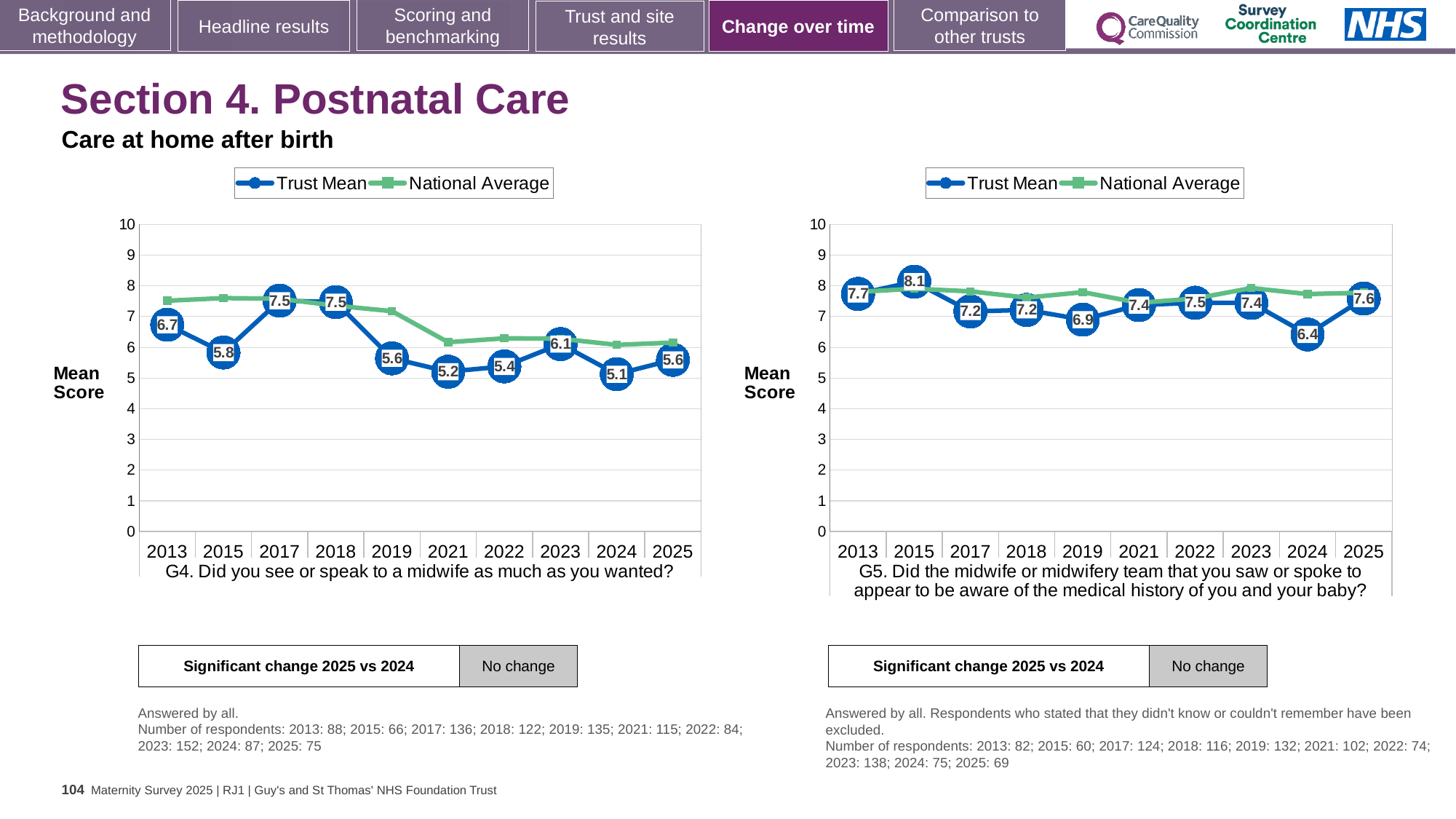
What type of chart is the G4 chart on the left? Line chart In the G4 chart (left), what is the difference between the Trust Mean scores for 2017 and 2025? 1.9 In the G4 chart (left), what is the Trust Mean score for 2024? 5.1 In the G5 chart (right), what is the Trust Mean score for 2015? 8.1 In the G4 chart (left), which year has the lowest Trust Mean score? 2024 In the G5 chart (right), which year has the highest Trust Mean score? 2015 In the G4 chart (left), is the National Average for 2013 greater or less than 7? greater In the G5 chart (right), which year has the lowest Trust Mean score? 2024 In the G4 chart (left), how many years are shown on the x axis? 10 In the G4 chart (left), what is the Trust Mean score for 2013? 6.7 In the G5 chart (right), is the Trust Mean score for 2025 larger or smaller than the score for 2024? larger In the G5 chart (right), how many series does the legend list? 2